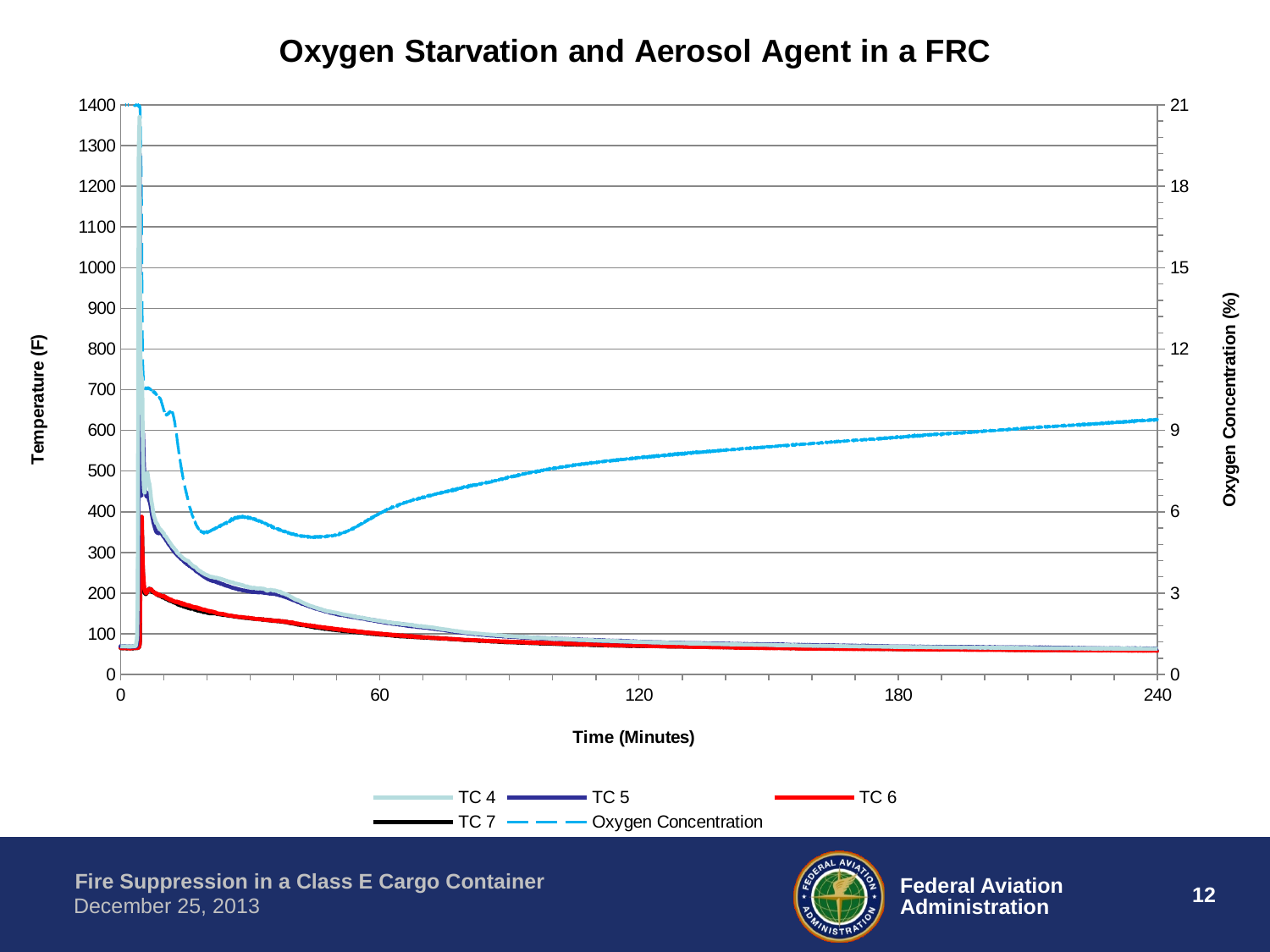
Is the peak value of TC 4 greater or less than 1000? greater After its early peak, does TC 5 rise or fall over the rest of the time axis? fall Is the value of TC 4 at 60 minutes greater or less than 200? less Is the Oxygen Concentration at 120 minutes greater or less than 6? greater How many series does the legend list? 5 Does the Oxygen Concentration rise or fall between 60 and 240 minutes? rise What kind of chart is shown on the slide? line chart What is the title of the chart? Oxygen Starvation and Aerosol Agent in a FRC What is the label of the right-hand vertical axis? Oxygen Concentration (%)